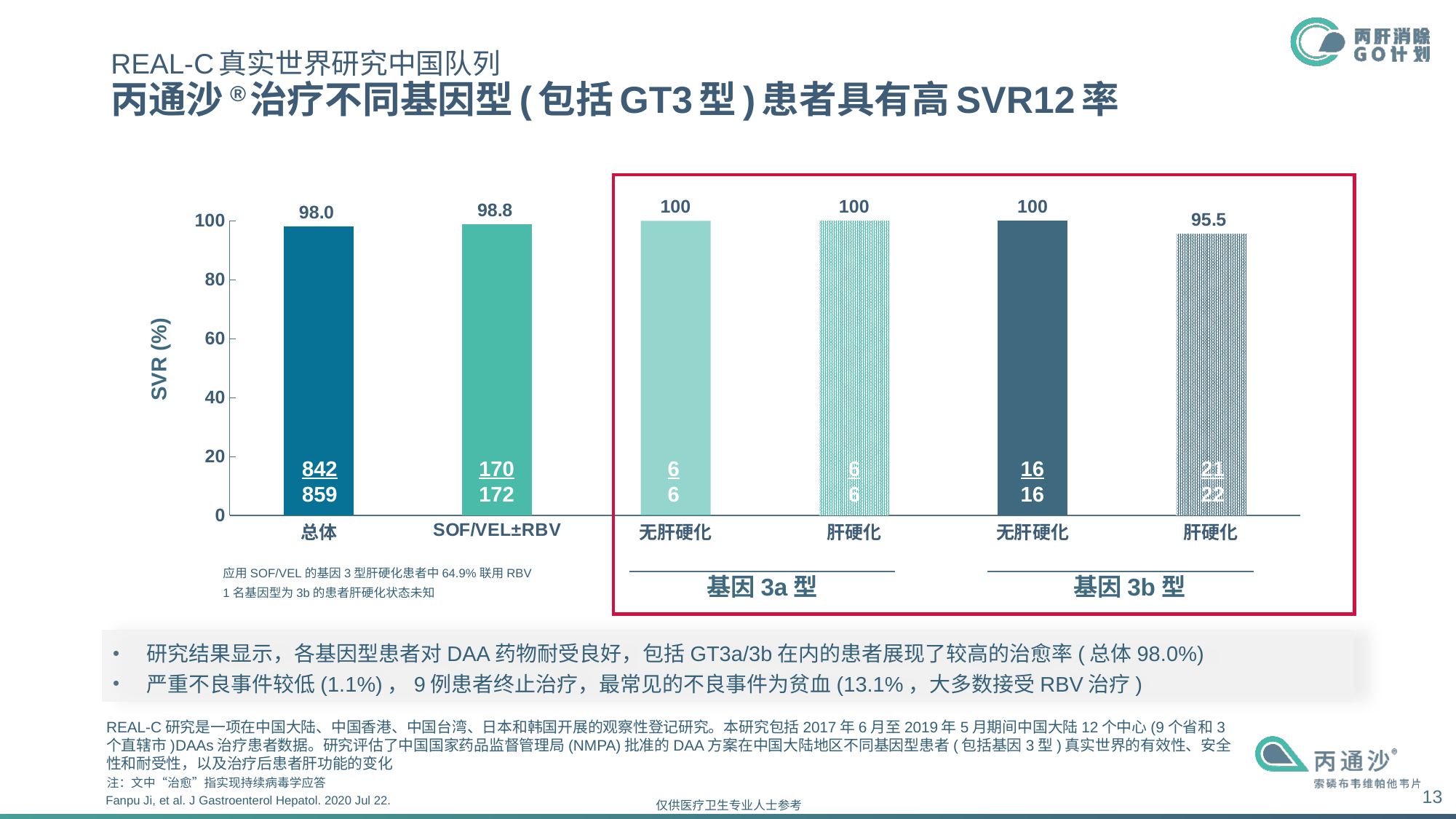
What is the SVR (%) value for the 总体 bar? 98.0 What is the SVR (%) value for the 无肝硬化 bar in the 基因 3a 型 group? 100 Which is larger, the SVR (%) for 总体 or for the 肝硬化 bar in the 基因 3b 型 group? 总体 What type of chart is shown on the slide? Bar chart How many bars are plotted in the chart? 6 What is the difference in SVR (%) between the 无肝硬化 bar and the 肝硬化 bar in the 基因 3b 型 group? 4.5 What patient count fraction is printed inside the 总体 bar? 842/859 What is the SVR (%) value for the 肝硬化 bar in the 基因 3b 型 group? 95.5 What is the SVR (%) value for the SOF/VEL±RBV bar? 98.8 What is the label of the y axis? SVR (%) Which bar has the lowest SVR (%) value? 肝硬化 (基因 3b 型) What is the difference in SVR (%) between the SOF/VEL±RBV bar and the 总体 bar? 0.8